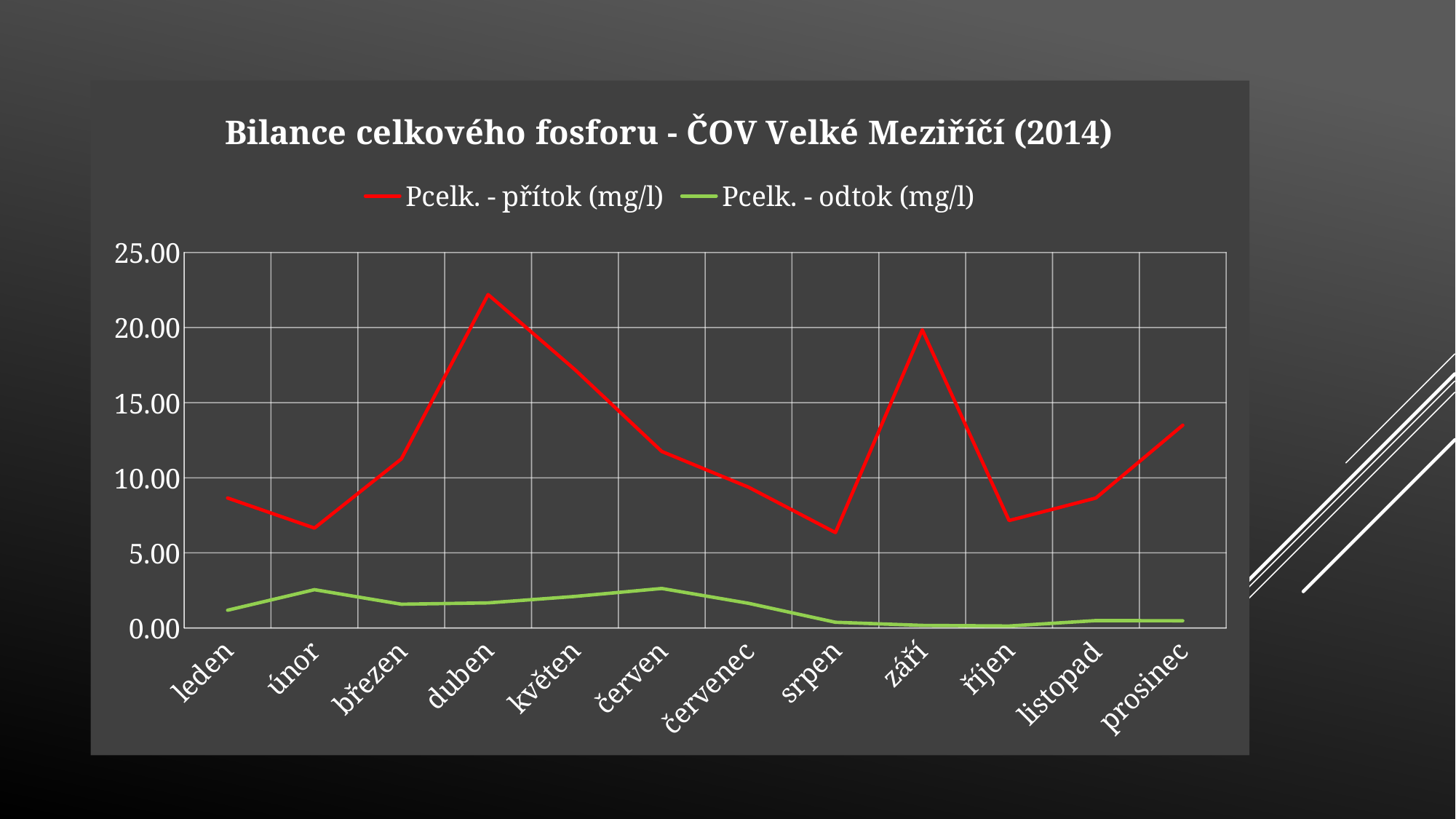
Which is larger, the Pcelk. - přítok (mg/l) value for březen or for červenec? březen Is the Pcelk. - odtok (mg/l) value for červen greater or less than 5.00? less What is the title of the chart? Bilance celkového fosforu - ČOV Velké Meziříčí (2014) Which is larger, the Pcelk. - přítok (mg/l) value for duben or for září? duben Does the Pcelk. - přítok (mg/l) line rise or fall from duben to srpen? fall What kind of chart is shown on the slide? line chart How many series does the legend list? 2 Is the Pcelk. - přítok (mg/l) value for srpen greater or less than 10.00? less How many months are plotted along the x axis? 12 In which month is the Pcelk. - přítok (mg/l) value highest? duben Is the Pcelk. - přítok (mg/l) value for duben greater or less than 20.00? greater